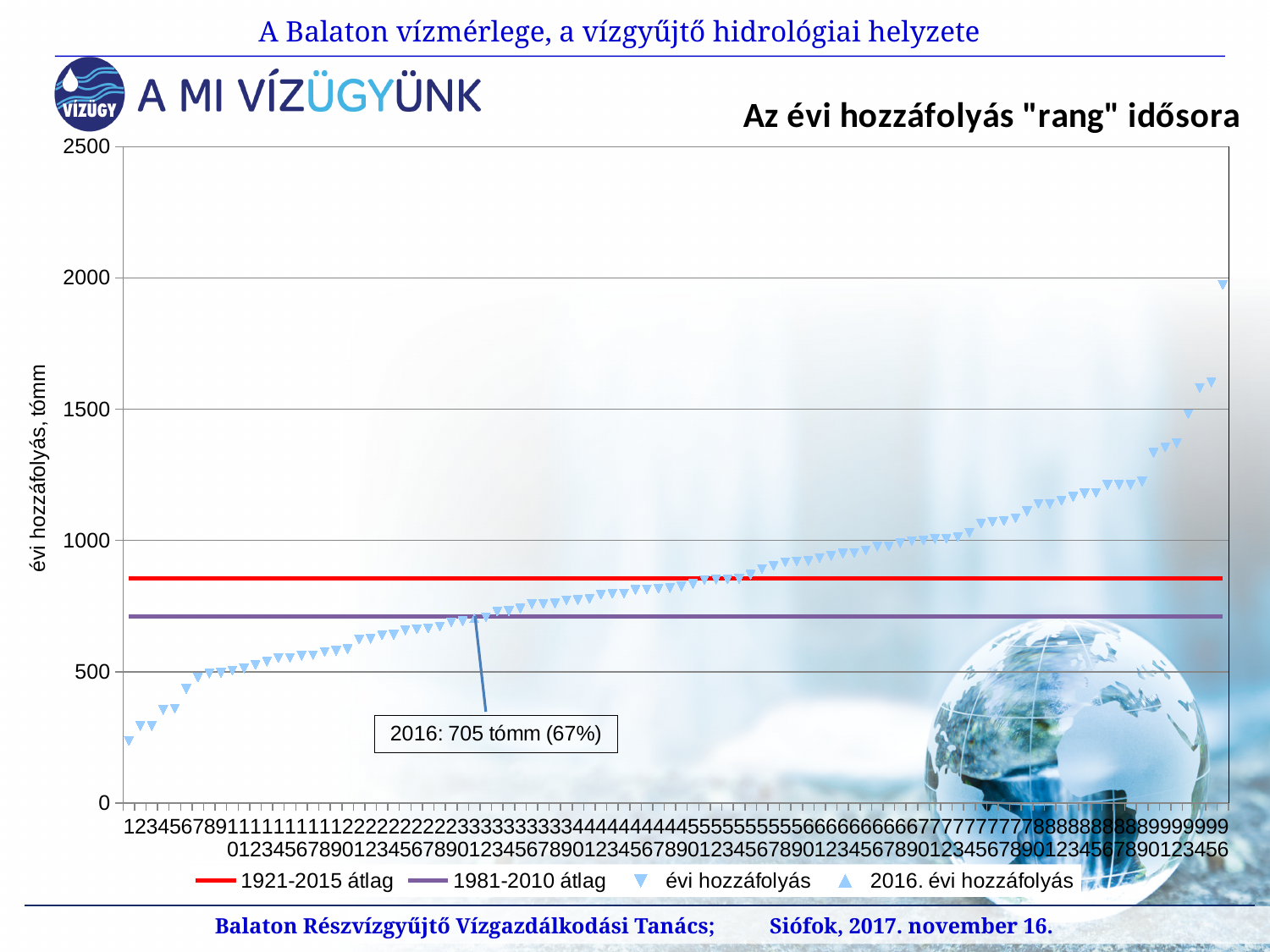
Is the 1981-2010 átlag line greater or less than 500? greater How many series does the chart legend list? 4 Is the 2016 inflow value greater or less than the 1921-2015 átlag line? less Which average line is higher, 1921-2015 átlag or 1981-2010 átlag? 1921-2015 átlag What is the label of the vertical axis? évi hozzáfolyás, tómm Do the évi hozzáfolyás values rise or fall from left to right along the x axis? rise Is the highest évi hozzáfolyás point greater or less than 1500? greater Is the lowest évi hozzáfolyás point greater or less than 500? less What is the 2016 annual inflow value shown in the annotation? 705 tómm What percentage is given for the 2016 inflow in the annotation? 67% What is the title of the chart? Az évi hozzáfolyás "rang" idősora